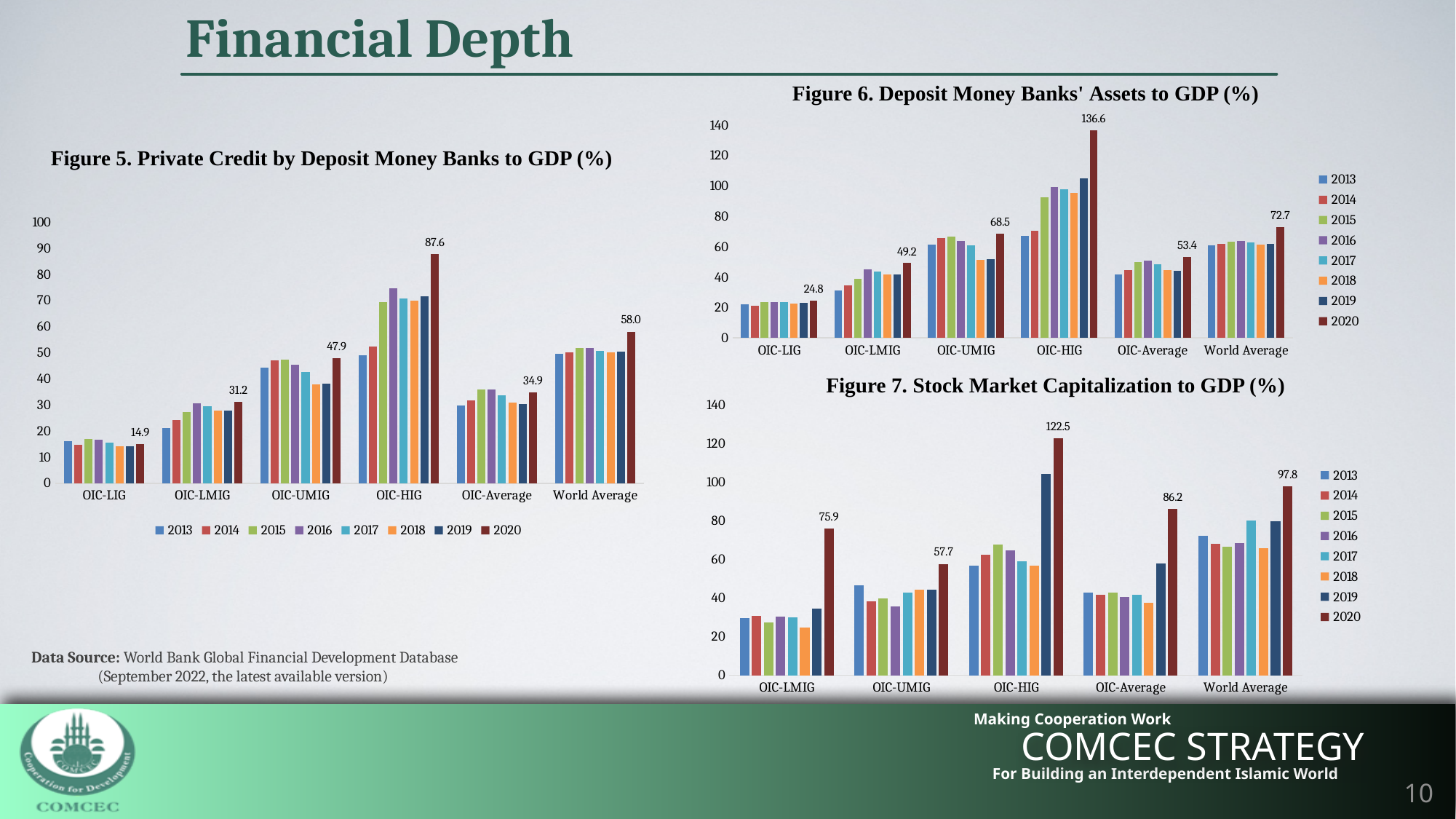
In Figure 5, which year is listed first in the legend? 2013 In Figure 7, which category has the lowest 2020 value? OIC-UMIG What kind of chart is Figure 5? Bar chart In Figure 6, which is larger in 2020: OIC-LMIG or OIC-Average? OIC-Average In Figure 5 (Private Credit by Deposit Money Banks to GDP), what is the 2020 value for OIC-HIG? 87.6 In Figure 6, which category has the highest 2020 value? OIC-HIG In Figure 7, how many categories are shown on the x axis? 5 In Figure 7, is the 2018 value for OIC-LMIG greater or less than 40? less In Figure 5, what is the difference between the 2020 values for OIC-HIG and World Average? 29.6 In Figure 6 (Deposit Money Banks' Assets to GDP), what is the 2020 value for World Average? 72.7 In Figure 7 (Stock Market Capitalization to GDP), what is the 2020 value for OIC-Average? 86.2 In Figure 6, how many series does the legend list? 8